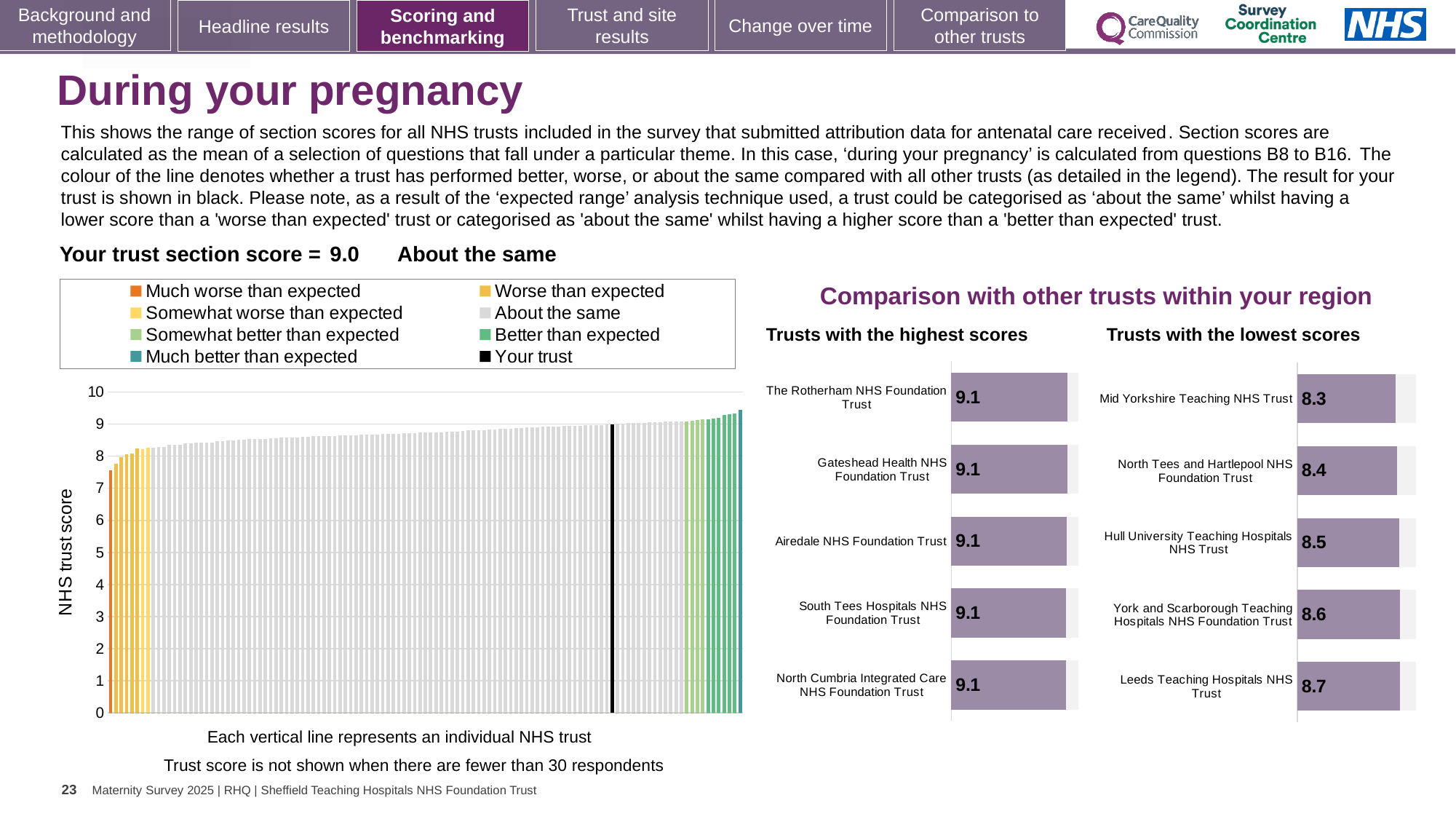
In the 'NHS trust score' chart on the left, do the bar values rise or fall from left to right? Rise What kind of chart is the large chart on the left with the 'NHS trust score' axis? Bar chart In the 'Trusts with the lowest scores' chart, what is the score for Mid Yorkshire Teaching NHS Trust? 8.3 In the 'Trusts with the lowest scores' chart, what is the score for Hull University Teaching Hospitals NHS Trust? 8.5 In the 'Trusts with the highest scores' chart, what is the score for Airedale NHS Foundation Trust? 9.1 In the 'Trusts with the lowest scores' chart, which has the larger score: North Tees and Hartlepool NHS Foundation Trust or York and Scarborough Teaching Hospitals NHS Foundation Trust? York and Scarborough Teaching Hospitals NHS Foundation Trust In the 'Trusts with the lowest scores' chart, what is the difference between the scores of Leeds Teaching Hospitals NHS Trust and Mid Yorkshire Teaching NHS Trust? 0.4 How many entries does the legend of the 'NHS trust score' bar chart on the left list? 8 In the 'NHS trust score' chart on the left, is the value of the leftmost (orange) bar greater or less than 8? less In the 'Trusts with the lowest scores' chart, which trust has the highest score? Leeds Teaching Hospitals NHS Trust In the 'Trusts with the lowest scores' chart, which trust has the lowest score? Mid Yorkshire Teaching NHS Trust How many trusts are shown in the 'Trusts with the highest scores' chart? 5